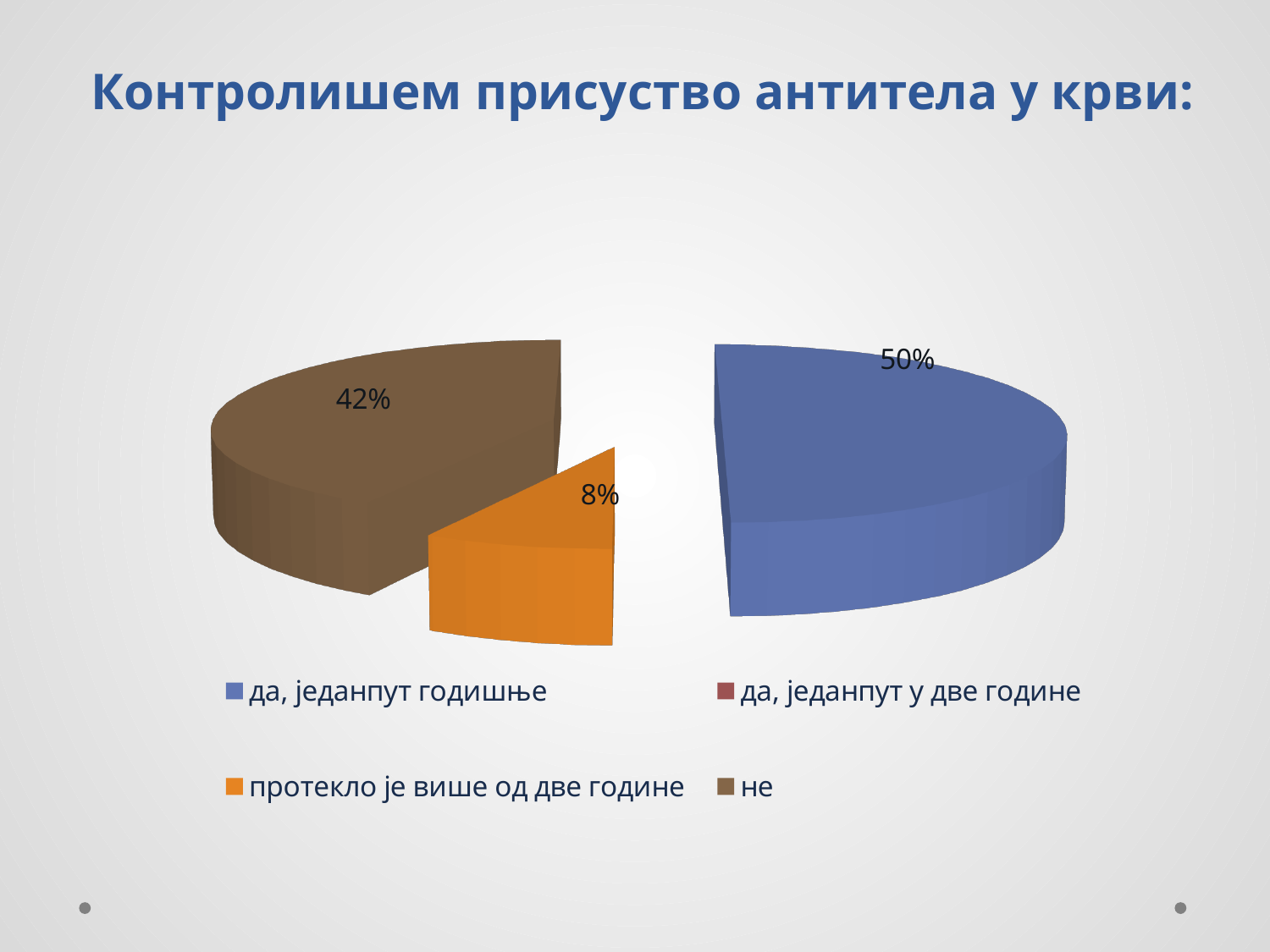
What is the title of the chart? Контролишем присуство антитела у крви: How many slices with data labels are visible in the pie? 3 What colour is the slice for "не"? brown Which category has the largest slice of the pie? да, једанпут годишње What percentage is shown for "да, једанпут годишње"? 50% What percentage is shown for "протекло је више од две године"? 8% What kind of chart is shown on the slide? pie chart What is the difference in percentage points between "да, једанпут годишње" and "не"? 8 Which labelled slice is the smallest? протекло је више од две године How many entries does the legend list? 4 Which is larger, the slice for "не" or the slice for "протекло је више од две године"? не What percentage is shown for "не"? 42%